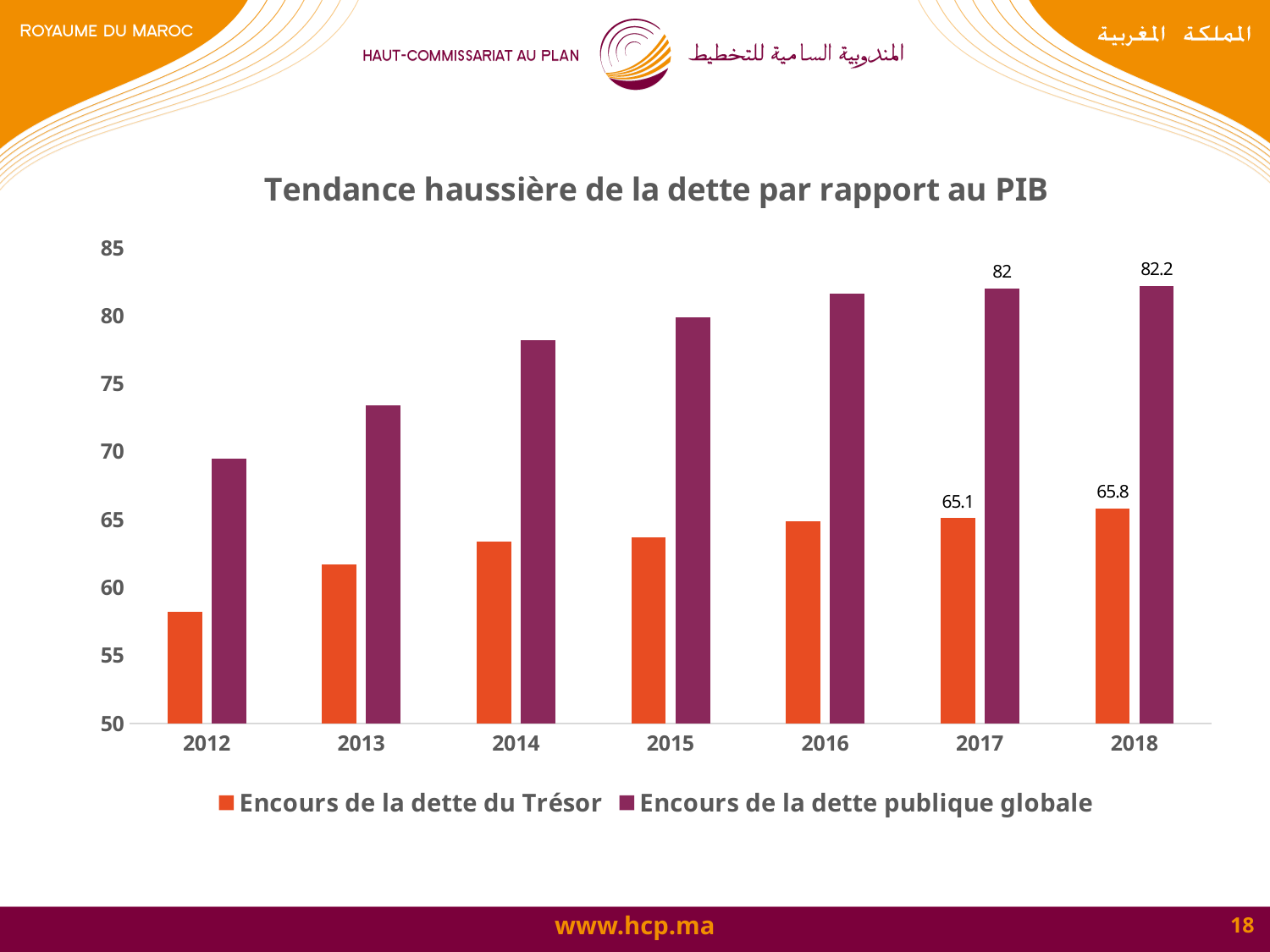
Which year has the highest value for Encours de la dette publique globale? 2018 What is the difference between Encours de la dette publique globale and Encours de la dette du Trésor in 2018? 16.4 What is the value of Encours de la dette publique globale in 2018? 82.2 What kind of chart is shown on the slide? Bar chart How many series does the legend list? 2 Which year has the lowest value for Encours de la dette du Trésor? 2012 What is the value of Encours de la dette du Trésor in 2017? 65.1 Is the value for Encours de la dette du Trésor in 2014 greater or less than 65? less How many years are shown on the x axis? 7 Is the value for Encours de la dette publique globale in 2012 greater or less than 70? less What is the value of Encours de la dette publique globale in 2017? 82 What is the value of Encours de la dette du Trésor in 2018? 65.8